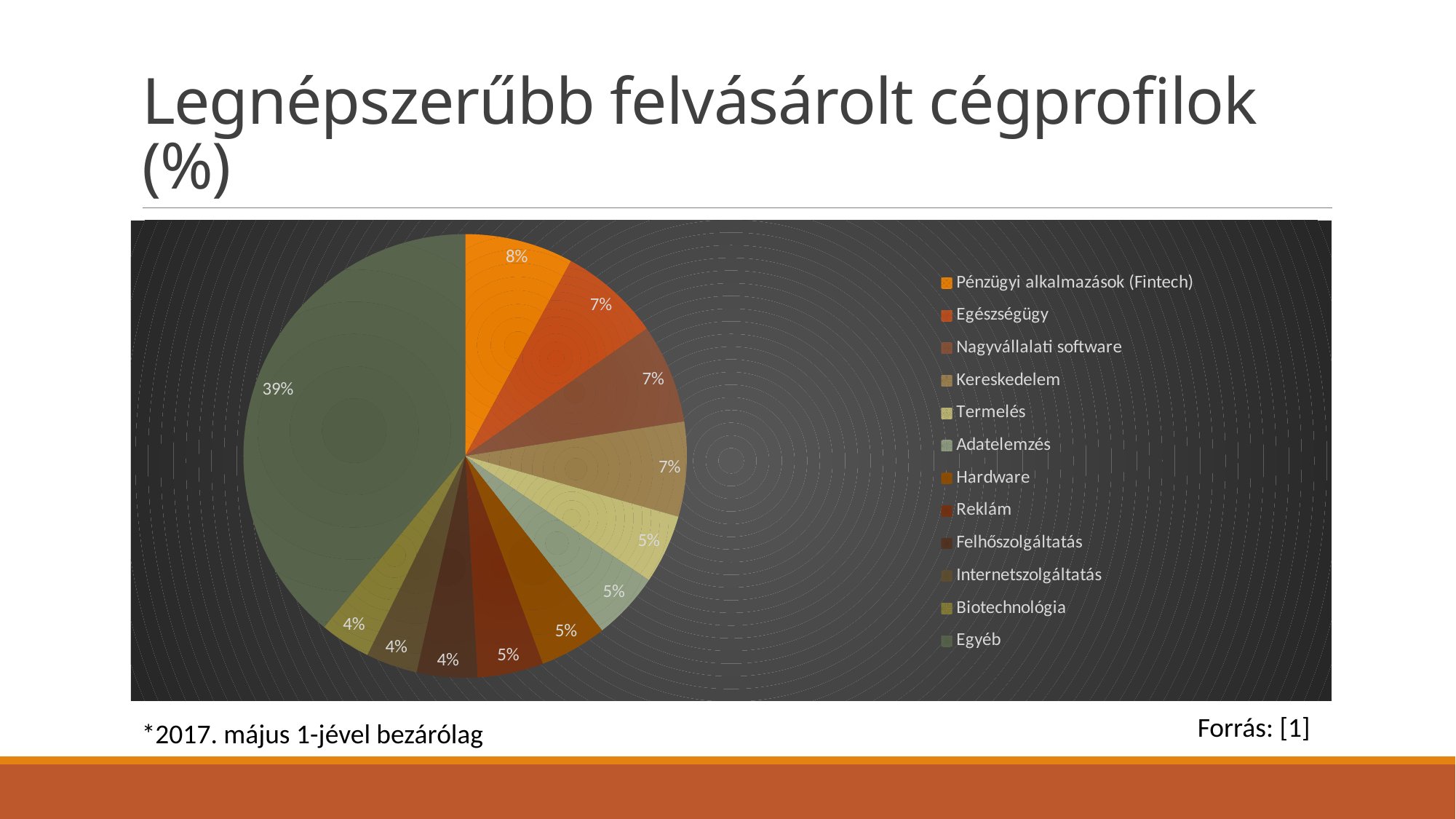
Which category has the largest slice of the pie? Egyéb What is the value for Biotechnológia? 4% What kind of chart is shown on the slide? pie chart What share of the pie does Egyéb have? 39% Which is larger, the slice for Pénzügyi alkalmazások (Fintech) or the slice for Hardware? Pénzügyi alkalmazások (Fintech) How many categories does the pie chart have? 12 Which legend entry is listed last? Egyéb What is the title of the slide containing the chart? Legnépszerűbb felvásárolt cégprofilok (%) What is the value for Egészségügy? 7% What is the difference in percentage points between Egyéb and Pénzügyi alkalmazások (Fintech)? 31 What is the value for Pénzügyi alkalmazások (Fintech)? 8% What is the value for Termelés? 5%